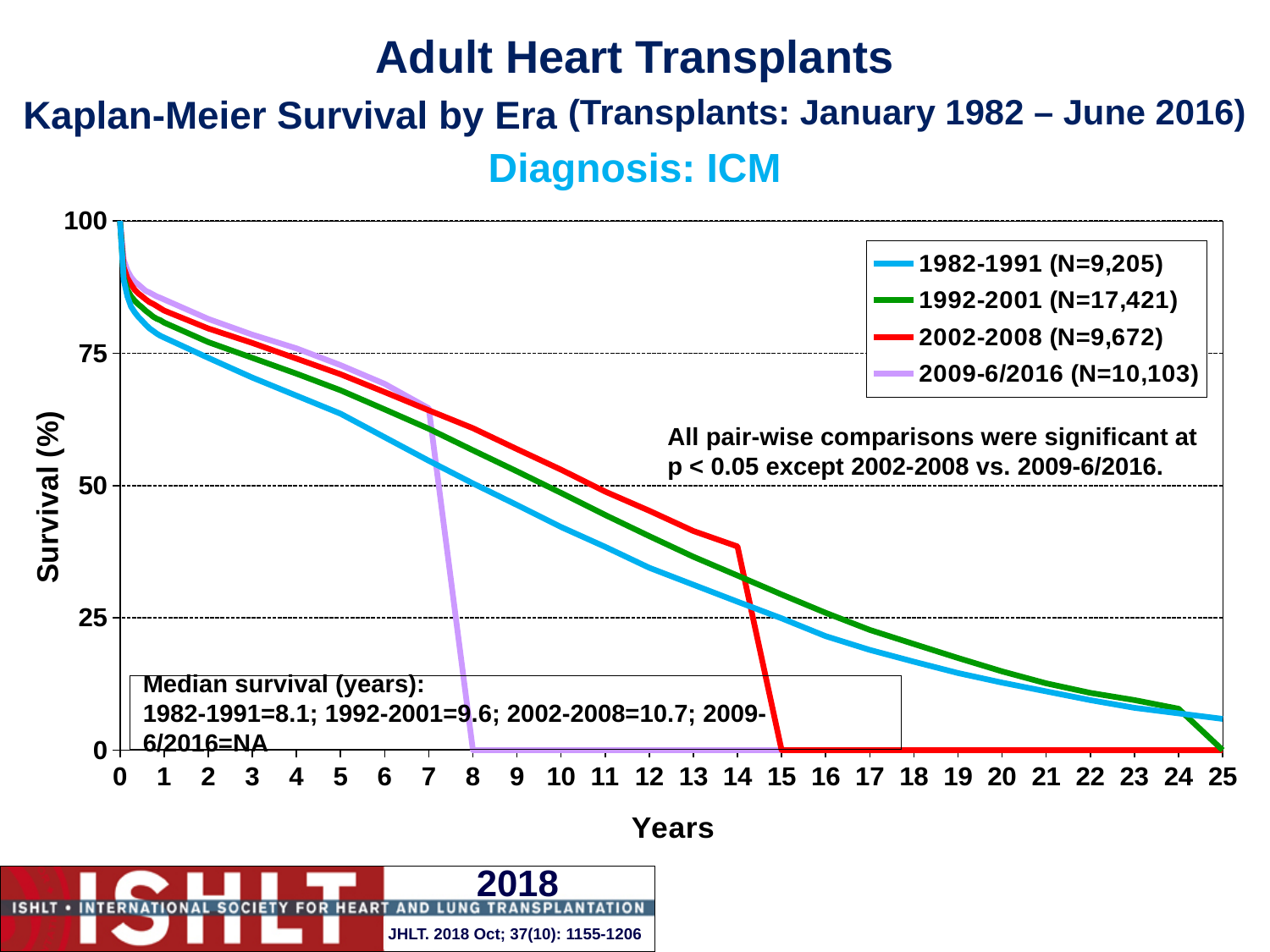
What is the median survival in years for the 1982-1991 era? 8.1 Do the survival curves rise or fall as years increase? fall What is the median survival in years for the 2002-2008 era? 10.7 What is the N for the 2009-6/2016 era shown in the legend? 10,103 Which era has the longest median survival? 2002-2008 What is the difference in median survival years between the 2002-2008 and 1982-1991 eras? 2.6 How many series does the legend list? 4 What kind of chart is shown on the slide? line chart What is the N for the 1992-2001 era shown in the legend? 17,421 What is the median survival in years for the 1992-2001 era? 9.6 At year 5, which era has higher survival, 1982-1991 or 2002-2008? 2002-2008 Is the survival value for the 1982-1991 era at year 5 greater or less than 50? greater